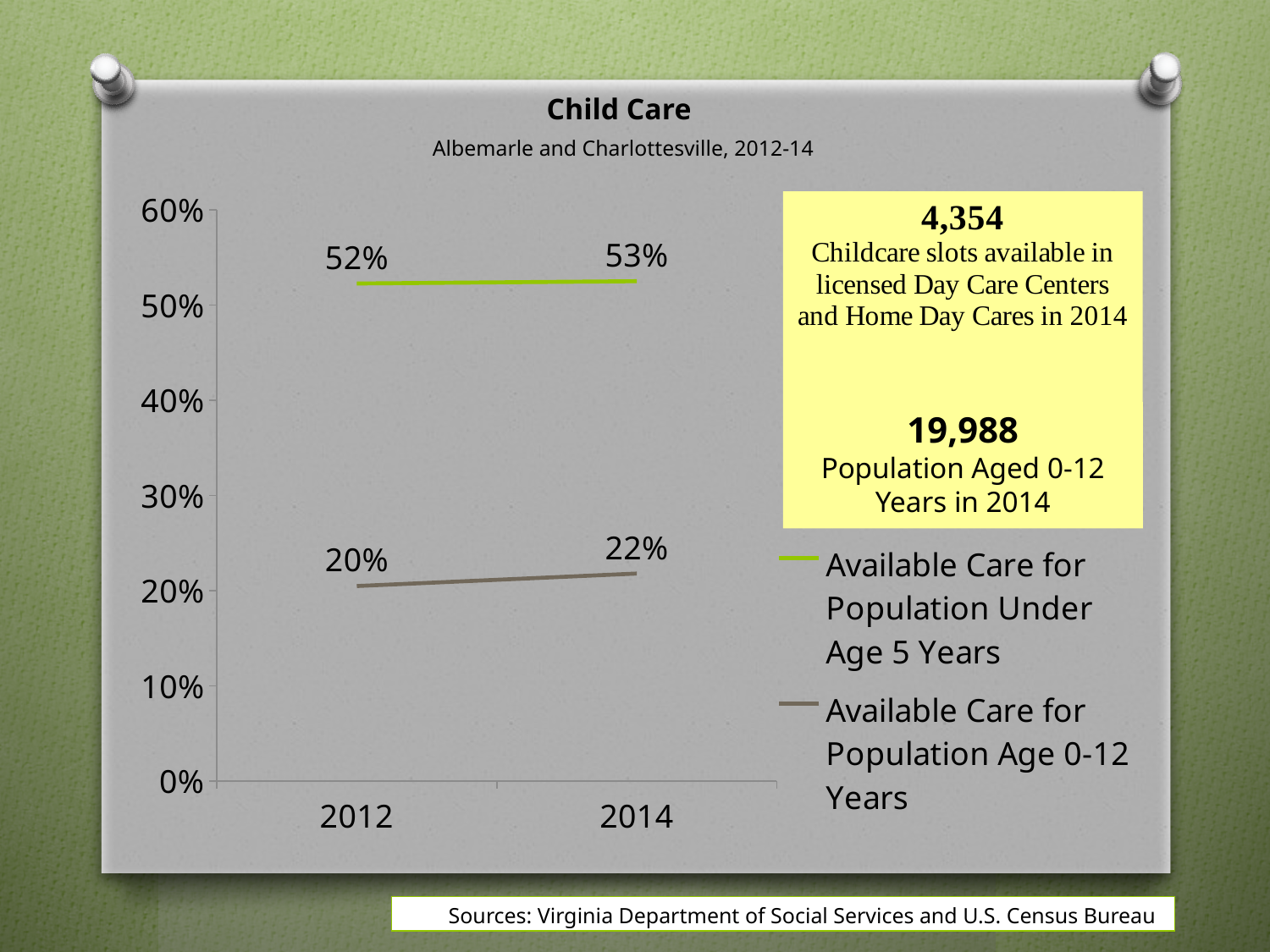
How many series does the legend list? 2 How many years are shown on the x axis? 2 What is the value for Available Care for Population Under Age 5 Years in 2012? 52% What kind of chart is shown on the slide? line chart Does the value for Available Care for Population Under Age 5 Years rise or fall from 2012 to 2014? rise What is the difference between the 2014 values for Available Care for Population Under Age 5 Years and Available Care for Population Age 0-12 Years? 31% Which series has the higher value in 2012, Available Care for Population Under Age 5 Years or Available Care for Population Age 0-12 Years? Available Care for Population Under Age 5 Years What is the value for Available Care for Population Under Age 5 Years in 2014? 53% What is the value for Available Care for Population Age 0-12 Years in 2014? 22% What is the value for Available Care for Population Age 0-12 Years in 2012? 20% By how much did Available Care for Population Age 0-12 Years change from 2012 to 2014? 2% What is the title of the chart? Child Care